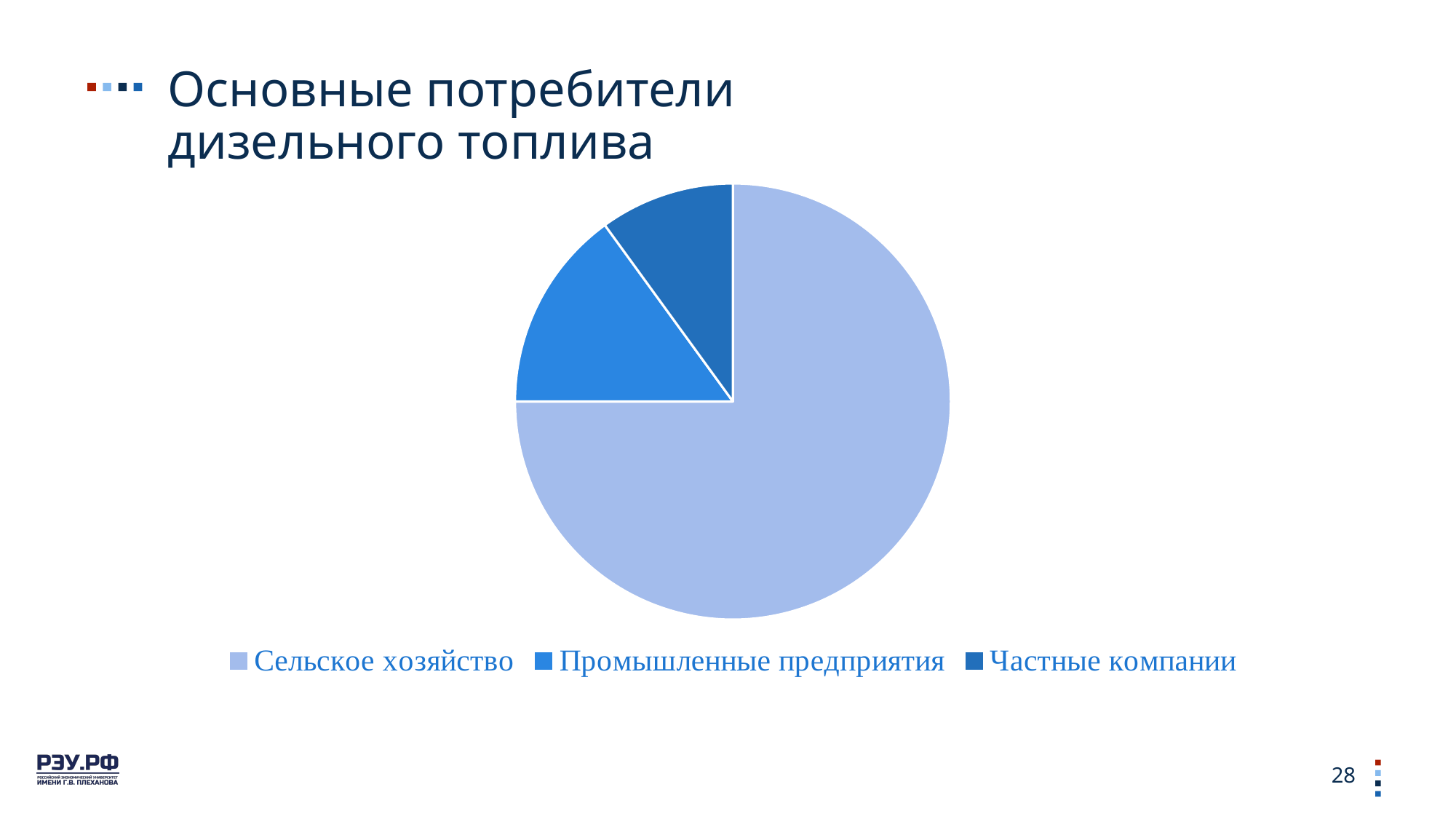
Which category has the largest slice of the pie chart? Сельское хозяйство How many slices does the pie chart have? 3 Which slice is larger: Сельское хозяйство or Промышленные предприятия? Сельское хозяйство Which slice is larger: Промышленные предприятия or Частные компании? Промышленные предприятия Which category has the smallest slice of the pie chart? Частные компании How many entries does the legend of the pie chart list? 3 What kind of chart is shown on the slide? pie chart Which legend entry is shown in the lightest blue colour? Сельское хозяйство What is the title of the slide containing the pie chart? Основные потребители дизельного топлива